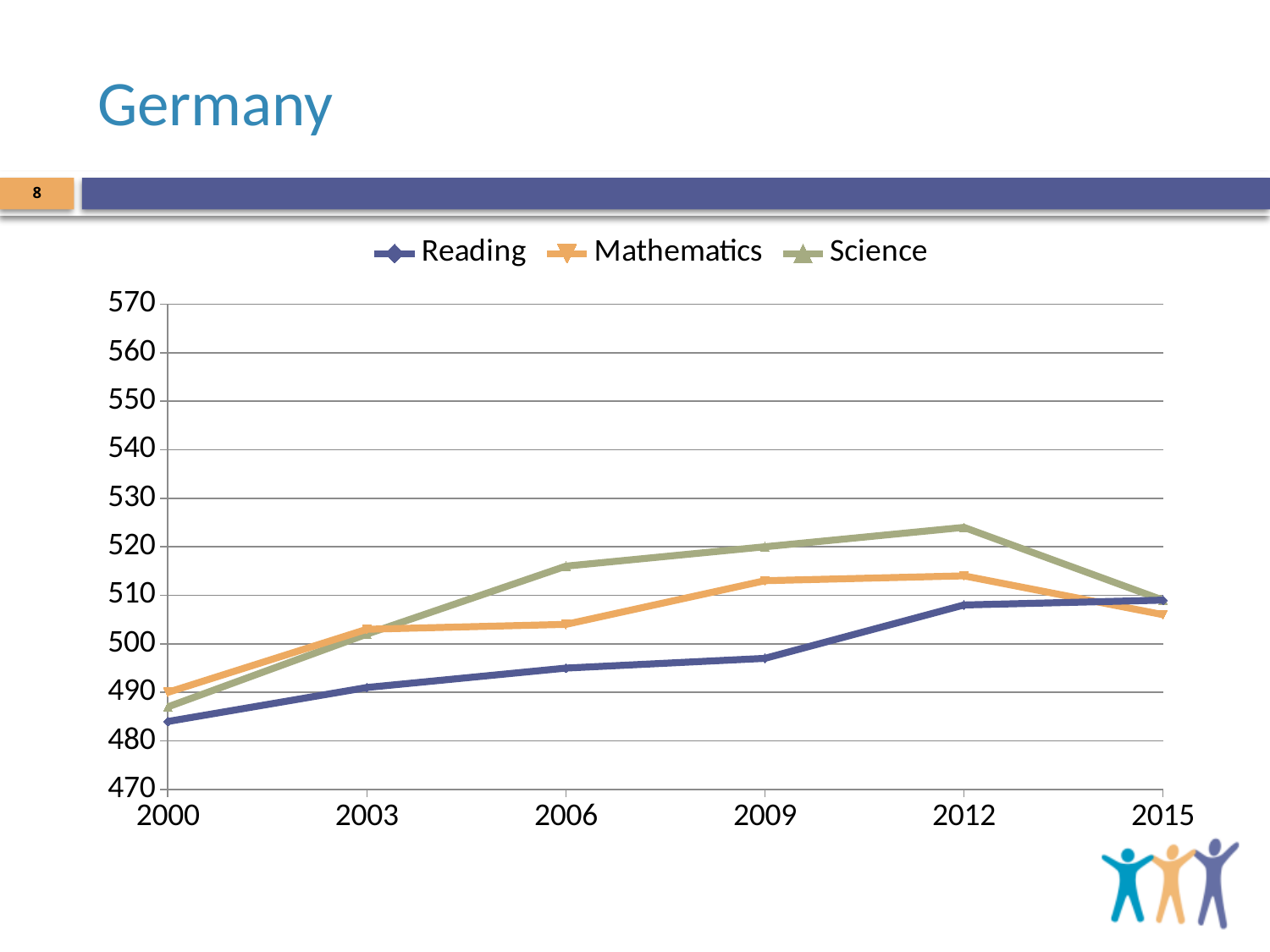
Which is larger in 2009, the Science value or the Mathematics value? Science Which series is drawn in orange in the legend? Mathematics Which series has the lowest value in 2006? Reading Is the value for Science in 2006 greater or less than 510? greater Does the Reading line rise or fall from 2000 to 2015? rise Is the value for Reading in 2000 greater or less than 490? less In which year does the Science line reach its highest value? 2012 How many series does the legend list? 3 What kind of chart is shown on the slide? line chart Which series has the highest value in 2012? Science How many years are shown along the x axis? 6 Is the value for Mathematics in 2015 greater or less than 500? greater